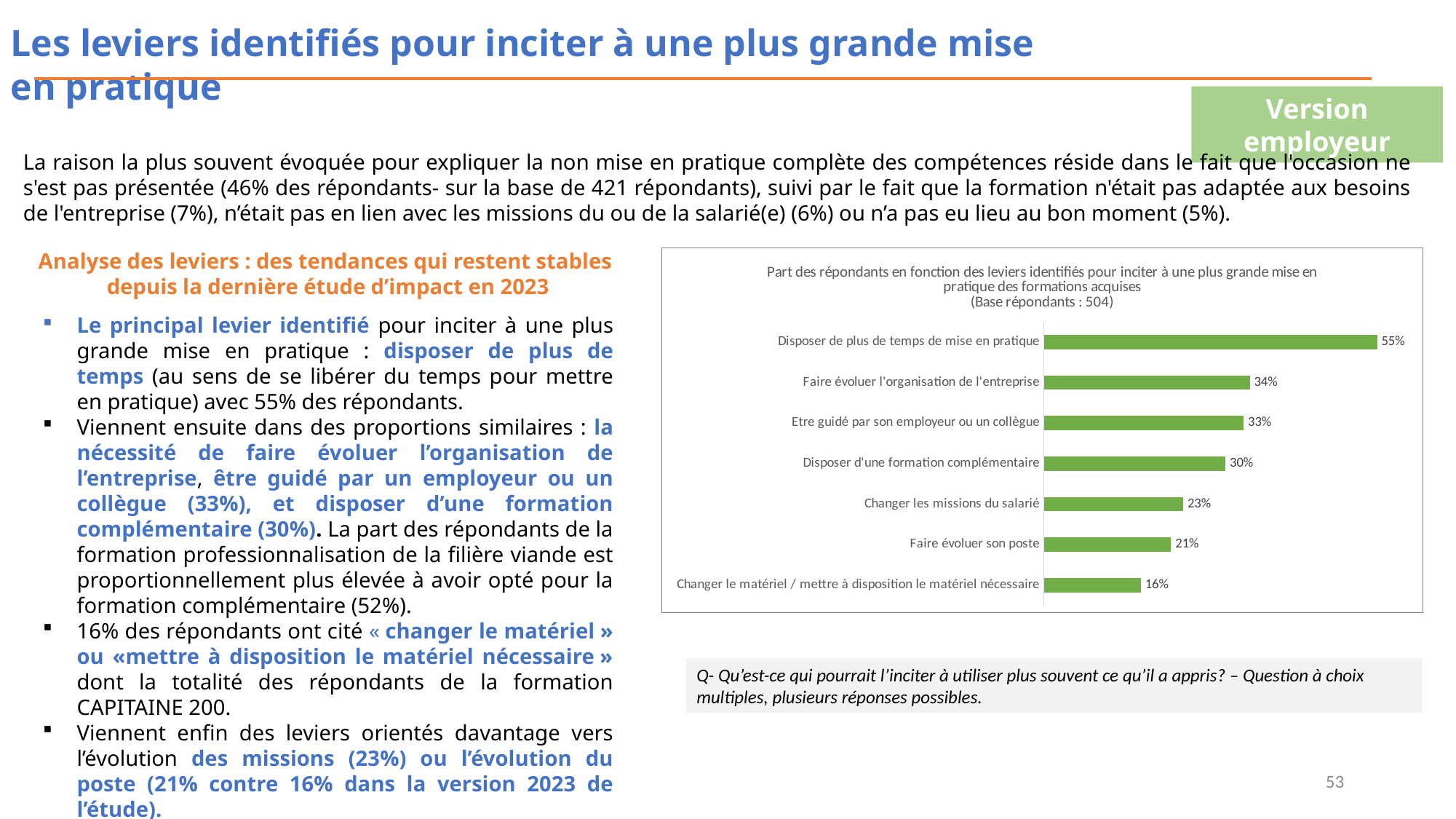
What is the value for "Changer le matériel / mettre à disposition le matériel nécessaire"? 16% Which is larger: "Disposer d'une formation complémentaire" or "Faire évoluer son poste"? Disposer d'une formation complémentaire What is the value for "Changer les missions du salarié"? 23% What colour are the bars in the chart? Green Which category has the lowest value? Changer le matériel / mettre à disposition le matériel nécessaire What is the difference between "Disposer de plus de temps de mise en pratique" and "Faire évoluer l'organisation de l'entreprise"? 21% How many categories are shown in the chart? 7 What is the value for "Disposer de plus de temps de mise en pratique"? 55% What is the value for "Faire évoluer l'organisation de l'entreprise"? 34% What kind of chart is shown? Bar chart Which category has the highest value? Disposer de plus de temps de mise en pratique What is the base number of respondents stated in the chart title? 504